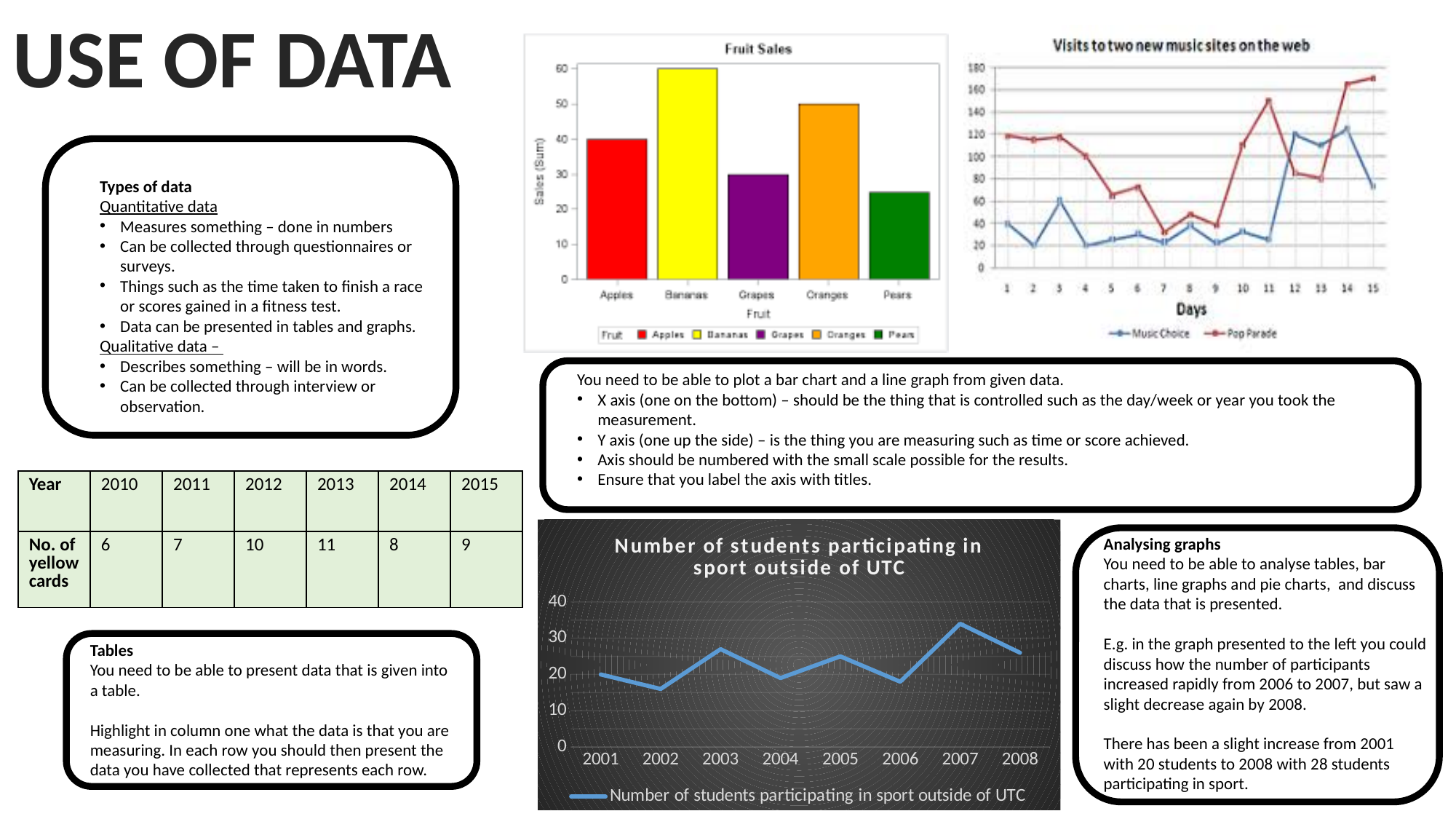
How many series does the legend list in the 'Visits to two new music sites on the web' chart? 2 In the Fruit Sales chart, what is the sales value for Grapes? 30 In the Fruit Sales chart, which fruit has the highest sales? Bananas In the 'Visits to two new music sites on the web' chart, which series has the higher value on day 12, Music Choice or Pop Parade? Music Choice In the Fruit Sales chart, what is the difference in sales between Oranges and Apples? 10 In the Fruit Sales chart, which fruit has the lowest sales? Pears In the 'Visits to two new music sites on the web' chart, is the Pop Parade value on day 15 greater or less than 160? greater How many fruit categories are shown in the Fruit Sales chart? 5 In the 'Number of students participating in sport outside of UTC' chart, which year has the highest value? 2007 What kind of chart is the 'Number of students participating in sport outside of UTC' chart? line chart In the Fruit Sales chart, is the value for Pears greater or less than 30? less In the Fruit Sales chart, what is the sales value for Bananas? 60